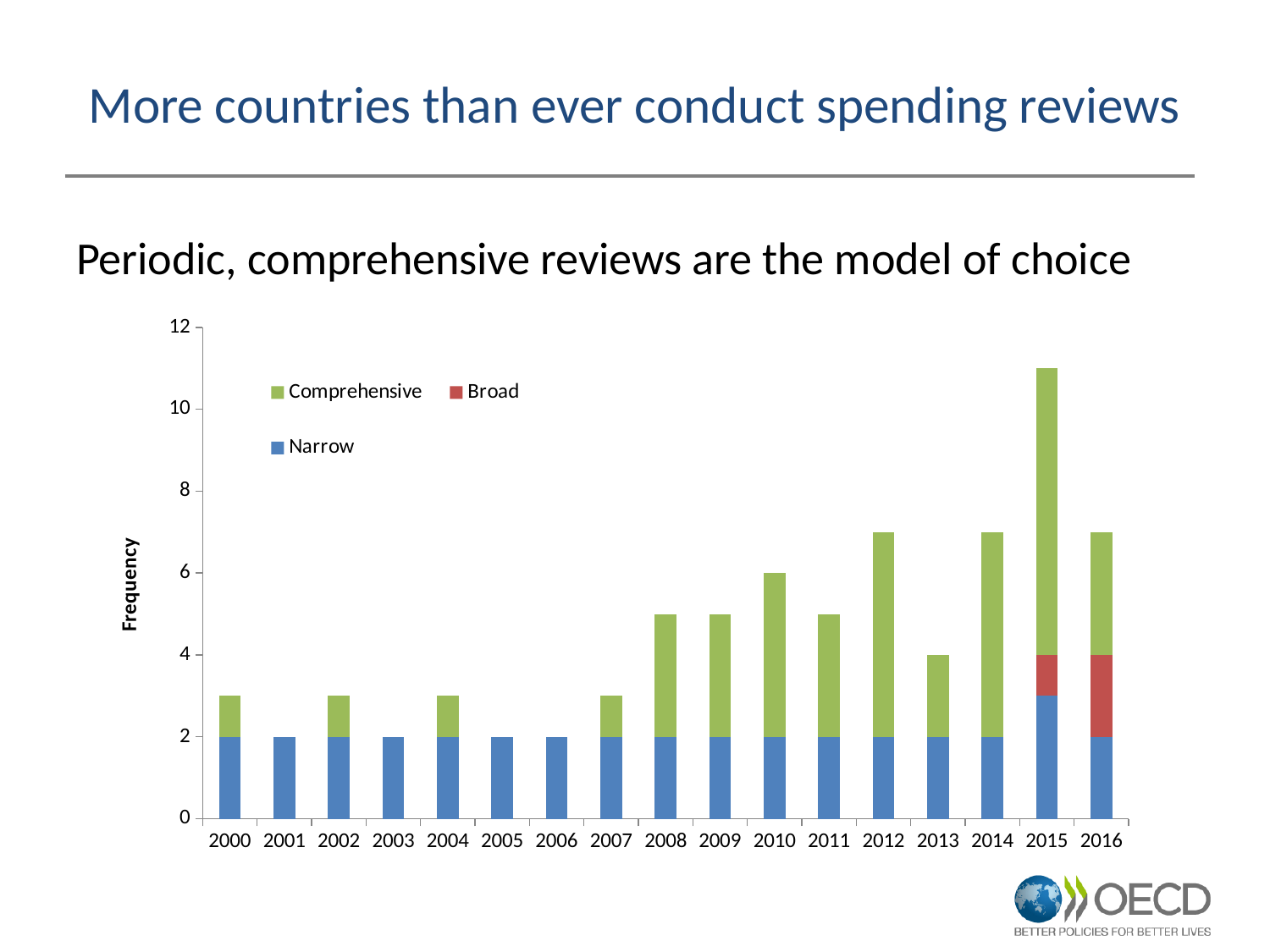
Is the total frequency for 2015 greater or less than 10? greater How many series does the chart legend list? 3 Is the total frequency for 2000 greater or less than 4? less What kind of chart is shown on the slide? bar chart Which year has the highest total frequency in the chart? 2015 Which year has the larger total frequency, 2012 or 2013? 2012 Do the total frequencies generally rise or fall from 2000 to 2016? rise What is the total frequency for 2010? 6 What is the total frequency for 2001? 2 What is the total frequency for 2013? 4 What is the label on the vertical axis of the chart? Frequency How many years are shown along the x axis of the chart? 17